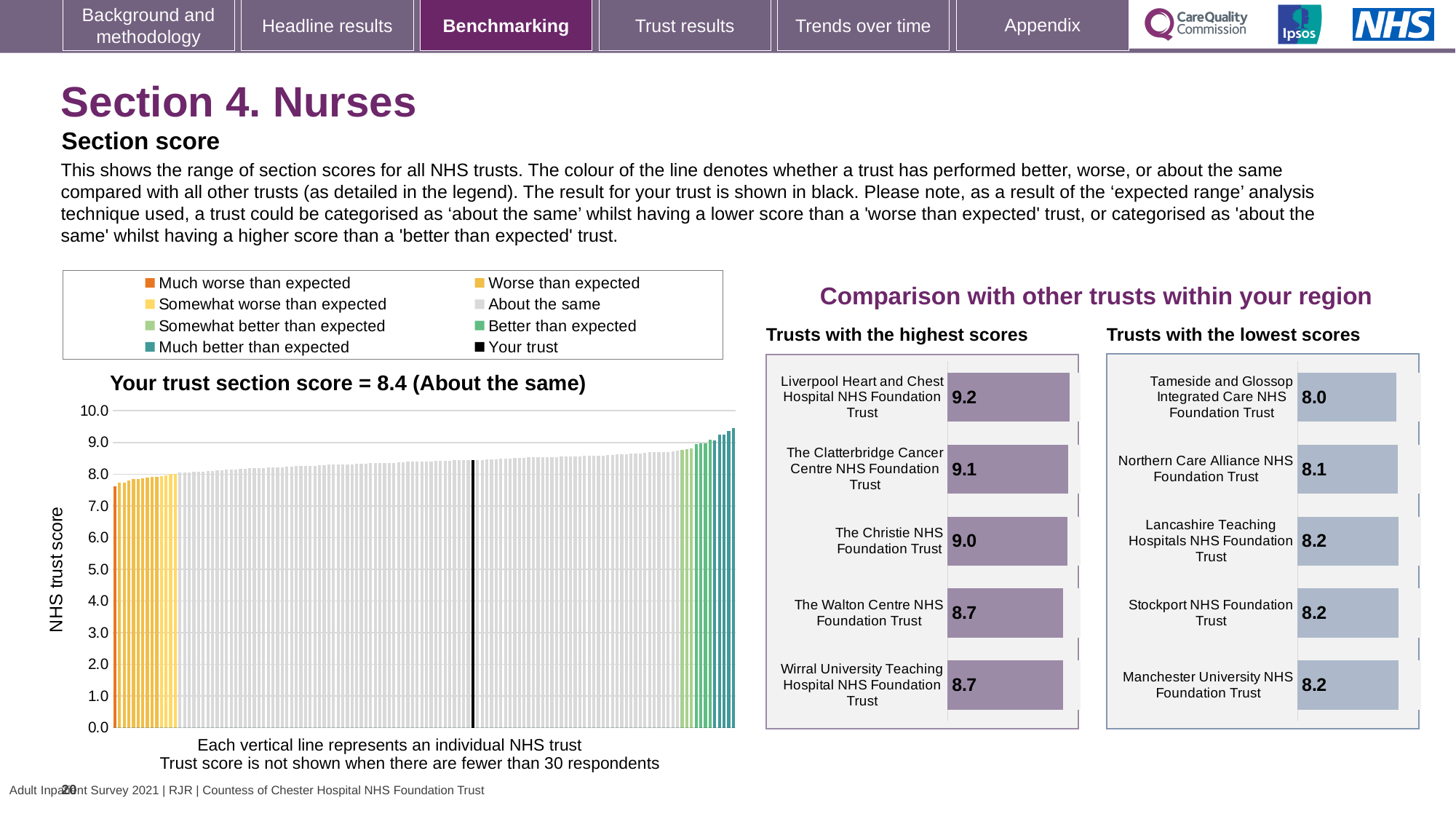
How many trusts are shown in the 'Trusts with the lowest scores' chart? 5 In the main chart on the left, do the trust scores rise or fall from left to right along the x axis? Rise In the 'Trusts with the lowest scores' chart, what is the score for Northern Care Alliance NHS Foundation Trust? 8.1 In the 'Trusts with the highest scores' chart, what is the score for Liverpool Heart and Chest Hospital NHS Foundation Trust? 9.2 In the 'Trusts with the lowest scores' chart, what is the score for Tameside and Glossop Integrated Care NHS Foundation Trust? 8.0 In the 'Trusts with the highest scores' chart, what is the score for The Christie NHS Foundation Trust? 9.0 What kind of chart is the main chart on the left showing all NHS trusts? Bar chart In the 'Trusts with the lowest scores' chart, which trust has the lowest score? Tameside and Glossop Integrated Care NHS Foundation Trust According to the title of the main chart on the left, what is your trust's section score? 8.4 In the 'Trusts with the highest scores' chart, which trust has the highest score? Liverpool Heart and Chest Hospital NHS Foundation Trust In the 'Trusts with the highest scores' chart, what is the difference between the scores of Liverpool Heart and Chest Hospital NHS Foundation Trust and The Walton Centre NHS Foundation Trust? 0.5 In the 'Trusts with the highest scores' chart, which has the larger score: The Clatterbridge Cancer Centre NHS Foundation Trust or The Christie NHS Foundation Trust? The Clatterbridge Cancer Centre NHS Foundation Trust